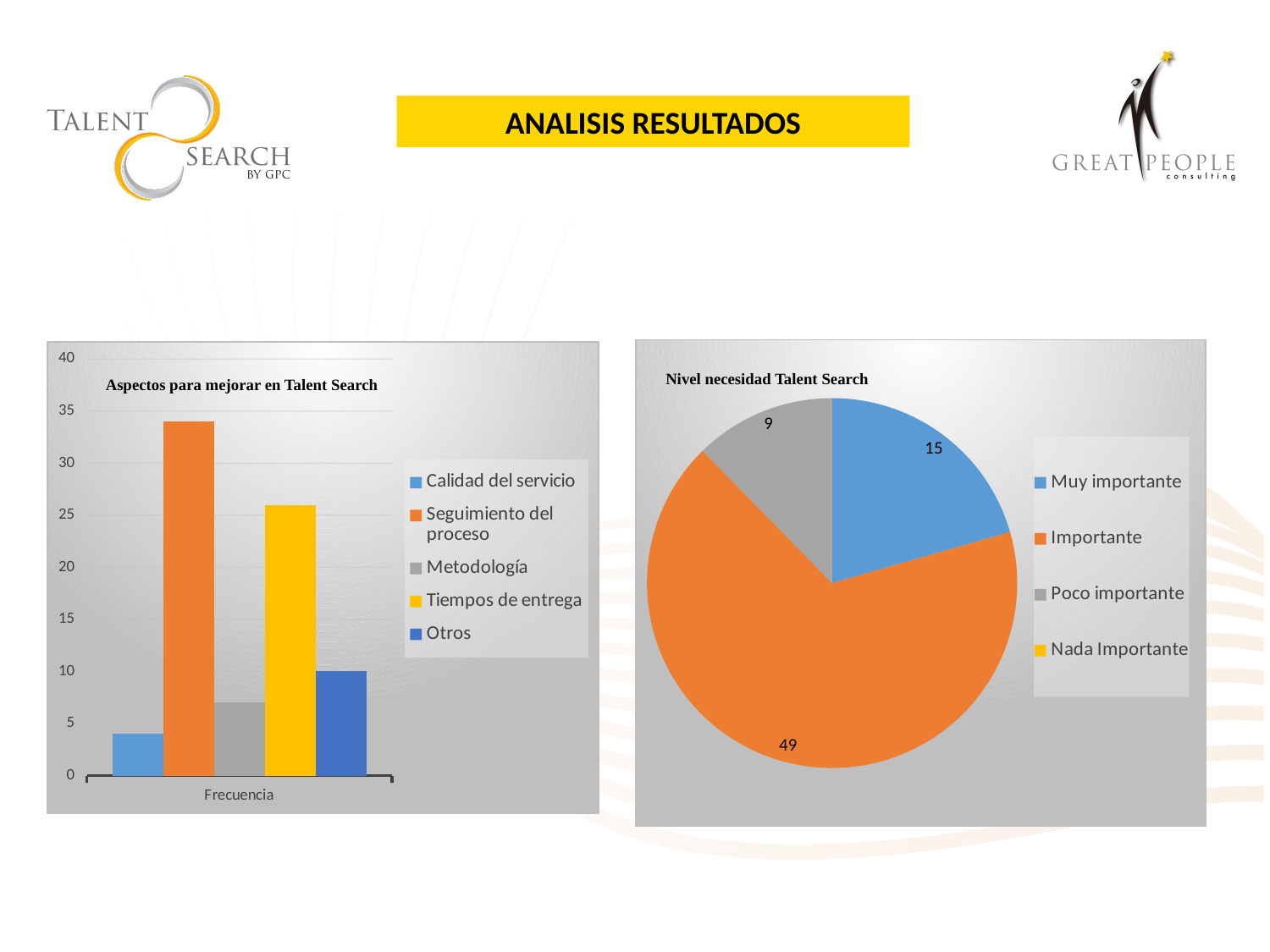
In the chart 'Aspectos para mejorar en Talent Search', is the value for Seguimiento del proceso greater or less than 30? greater In the chart 'Nivel necesidad Talent Search', what is the difference between Importante and Muy importante? 34 What kind of chart is the chart titled 'Aspectos para mejorar en Talent Search'? bar chart In the chart 'Nivel necesidad Talent Search', what is the value for Poco importante? 9 In the chart 'Aspectos para mejorar en Talent Search', how many series does the legend list? 5 In the chart 'Nivel necesidad Talent Search', what is the value for Importante? 49 In the chart 'Aspectos para mejorar en Talent Search', which series has the highest bar? Seguimiento del proceso In the chart 'Aspectos para mejorar en Talent Search', which is larger, Tiempos de entrega or Otros? Tiempos de entrega In the chart 'Nivel necesidad Talent Search', how many entries does the legend list? 4 In the chart 'Aspectos para mejorar en Talent Search', is the value for Metodología greater or less than 10? less What kind of chart is the chart titled 'Nivel necesidad Talent Search'? pie chart In the chart 'Aspectos para mejorar en Talent Search', which series has the lowest bar? Calidad del servicio